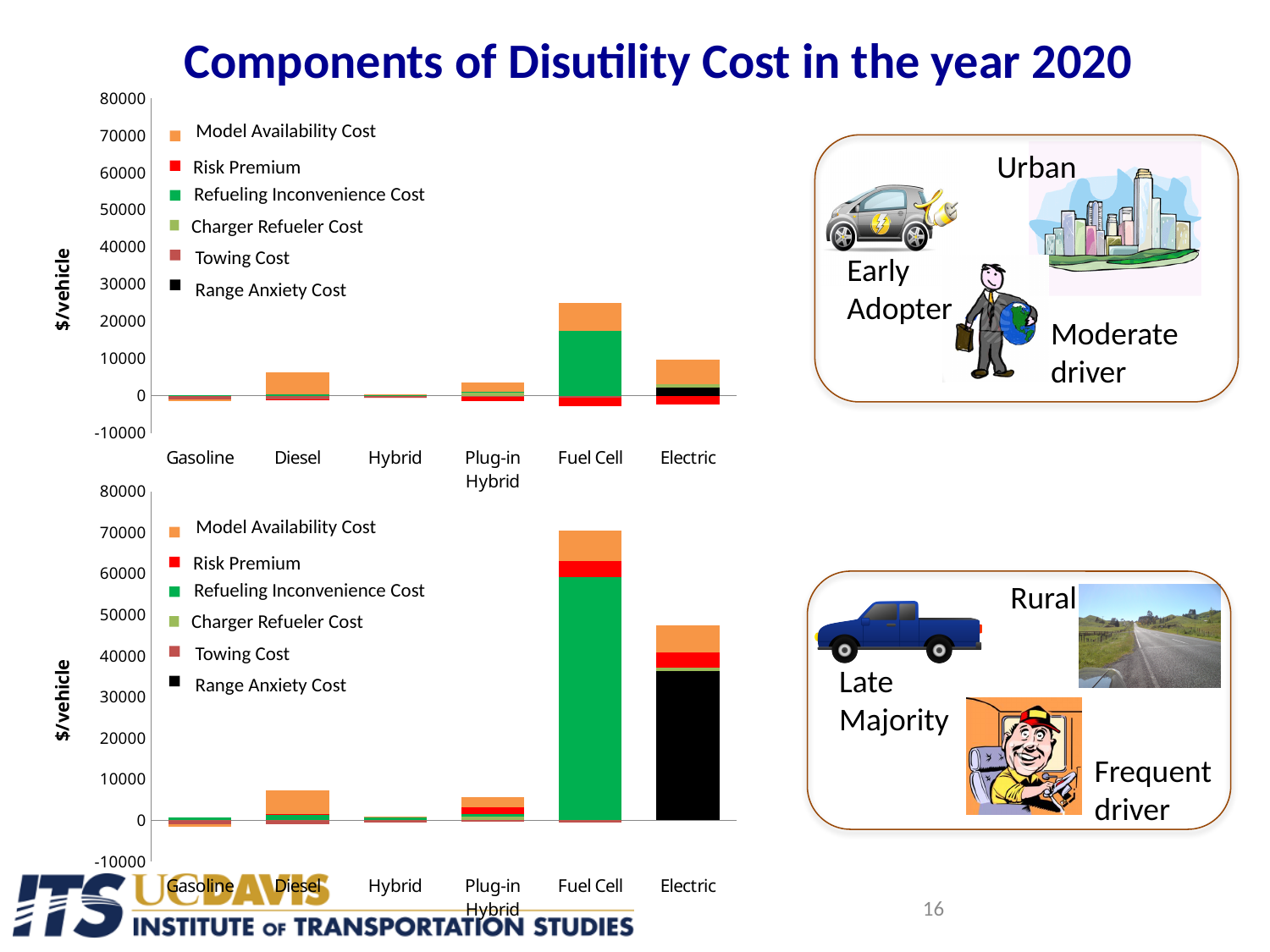
How many series does the legend of the top chart list? 6 How many vehicle categories are shown on the x axis of the bottom chart? 6 What is the title of the slide's charts? Components of Disutility Cost in the year 2020 In the bottom chart, is the top of the Fuel Cell bar greater or less than 60000? greater In the bottom chart, which bar is taller: Fuel Cell or Electric? Fuel Cell In the top chart, is the top of the Fuel Cell bar greater or less than 20000? greater In the bottom chart, which cost component makes up the largest part of the Electric bar? Range Anxiety Cost What kind of chart is the top chart on the slide? Stacked bar chart In the top chart, which vehicle category has the tallest bar? Fuel Cell In the top chart, is the top of the Diesel bar greater or less than 10000? less In the bottom chart, which vehicle category has the tallest bar? Fuel Cell